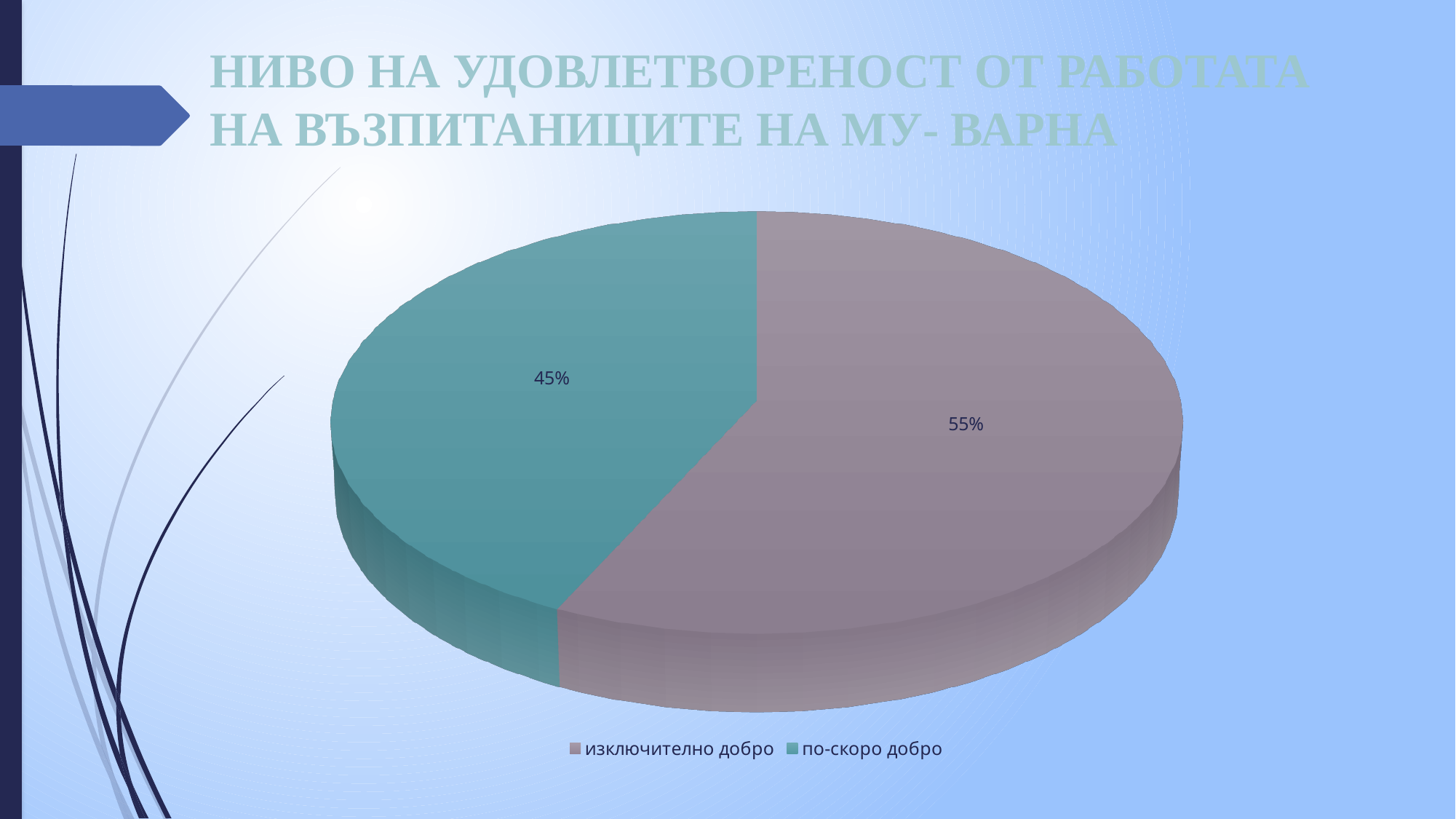
Which slice is larger, "изключително добро" or "по-скоро добро"? изключително добро What kind of chart is shown on the slide? pie chart Which category has the largest slice of the pie? изключително добро What share of the pie is labelled "по-скоро добро"? 45% How many slices does the pie chart have? 2 Is the share for "по-скоро добро" greater or less than 50%? less What colour is the "по-скоро добро" slice? teal/green How many entries does the legend list? 2 What is the difference in percentage points between the "изключително добро" and "по-скоро добро" slices? 10 Which category has the smallest slice of the pie? по-скоро добро What share of the pie is labelled "изключително добро"? 55%